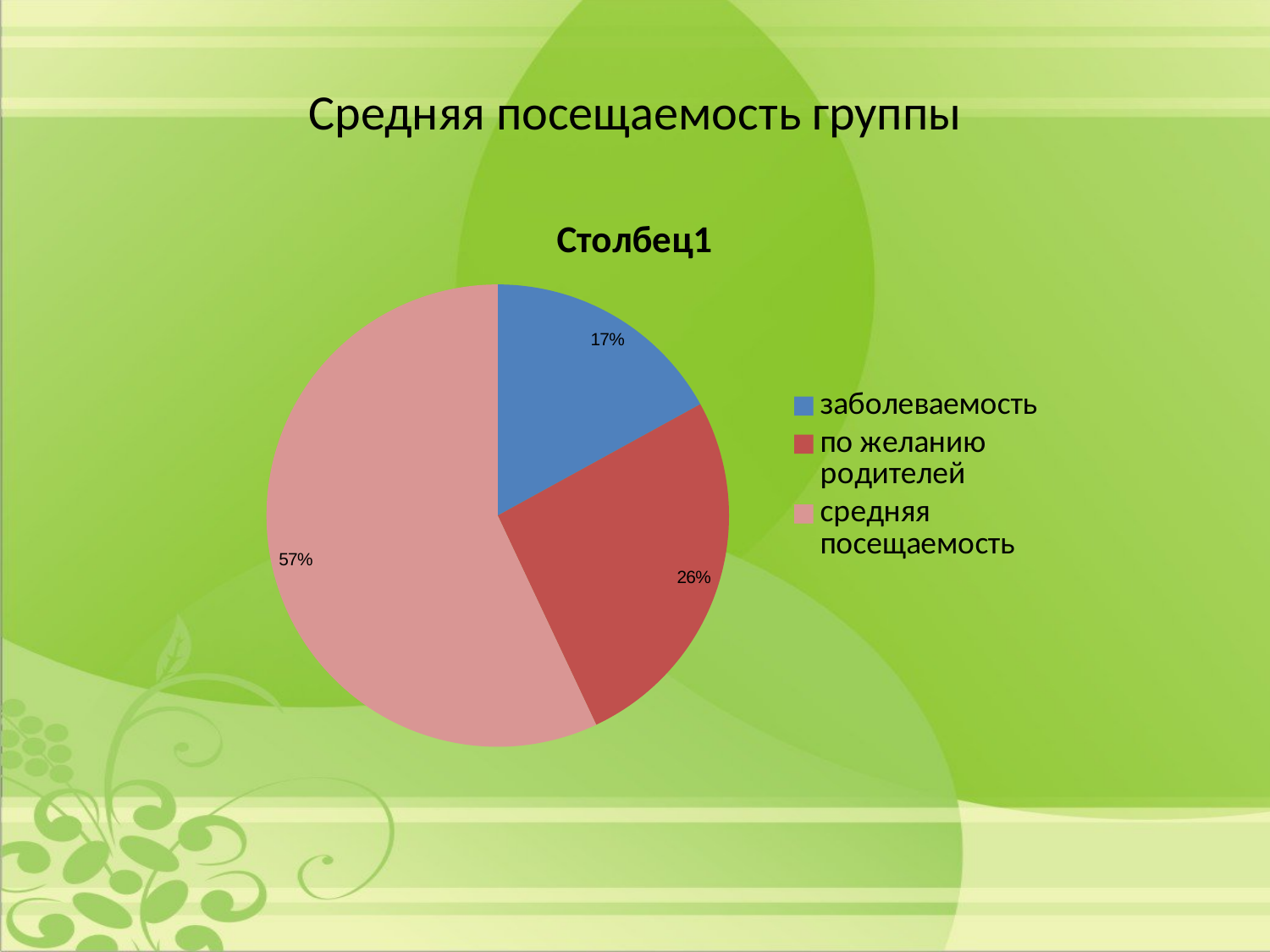
Which category has the largest slice of the pie? средняя посещаемость Which is larger, the slice for по желанию родителей or the slice for заболеваемость? по желанию родителей What type of chart is shown on the slide? pie chart What percentage does the slice for по желанию родителей show? 26% What colour is the slice for средняя посещаемость? pink How many categories does the legend list? 3 What is the difference in percentage points between средняя посещаемость and по желанию родителей? 31 What percentage does the slice for средняя посещаемость show? 57% Which category has the smallest slice of the pie? заболеваемость What is the difference in percentage points between по желанию родителей and заболеваемость? 9 What is the title of the chart? Столбец1 What percentage does the slice for заболеваемость show? 17%